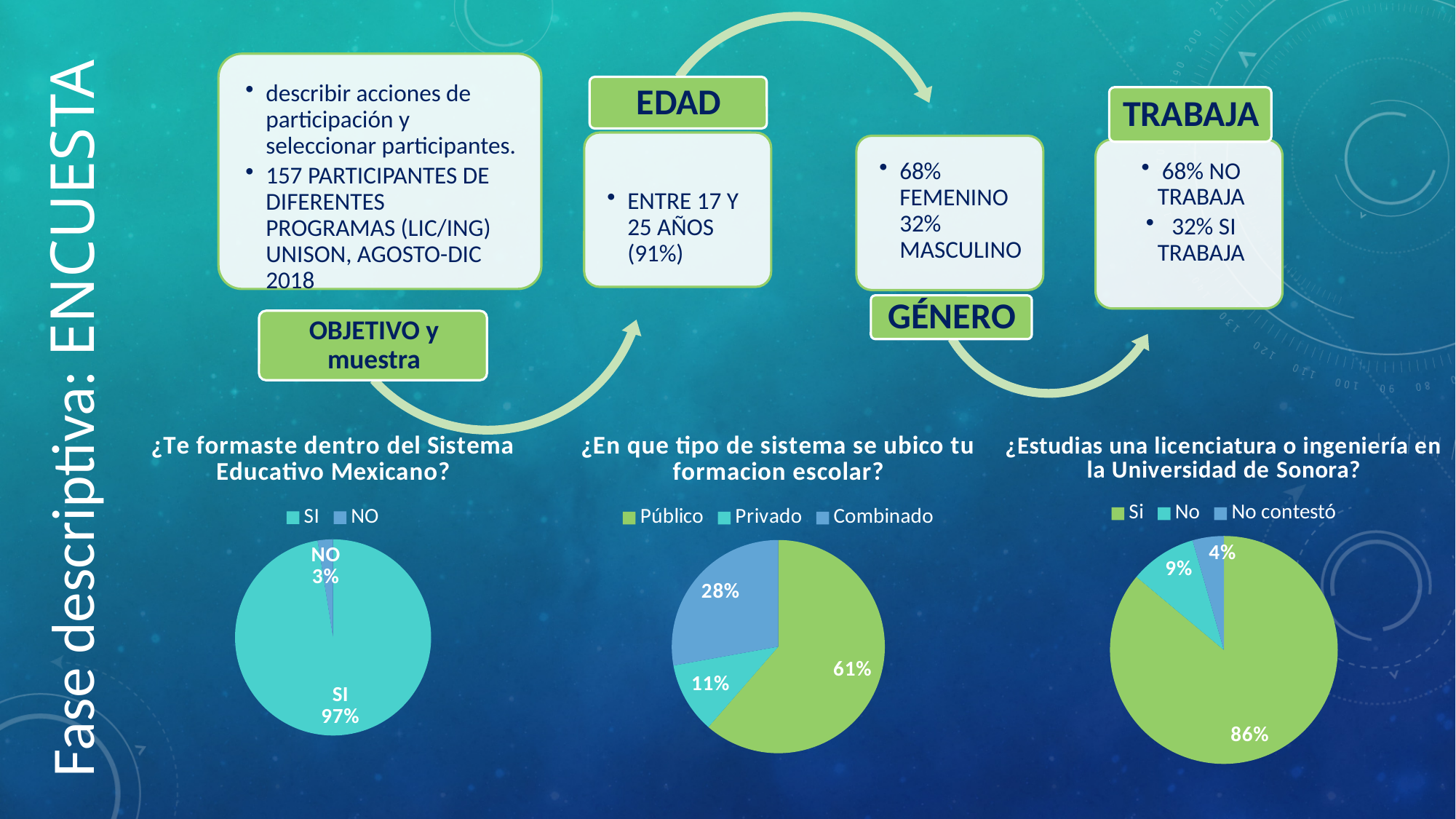
What kind of chart is used for '¿Te formaste dentro del Sistema Educativo Mexicano?'? Pie chart In the pie chart titled '¿En que tipo de sistema se ubico tu formacion escolar?', what is the share for Público? 61% In the pie chart titled '¿En que tipo de sistema se ubico tu formacion escolar?', which category has the smallest slice? Privado In the pie chart titled '¿Te formaste dentro del Sistema Educativo Mexicano?', what percentage answered NO? 3% How many pie charts are shown on the slide? 3 In the pie chart titled '¿Te formaste dentro del Sistema Educativo Mexicano?', what percentage answered SI? 97% In the pie chart titled '¿En que tipo de sistema se ubico tu formacion escolar?', what is the share for Privado? 11% In the pie chart titled '¿Estudias una licenciatura o ingeniería en la Universidad de Sonora?', what percentage answered Si? 86% In the pie chart titled '¿Estudias una licenciatura o ingeniería en la Universidad de Sonora?', which is larger, No or No contestó? No In the pie chart titled '¿Estudias una licenciatura o ingeniería en la Universidad de Sonora?', what percentage answered No contestó? 4% In the pie chart titled '¿En que tipo de sistema se ubico tu formacion escolar?', what is the difference between the Público and Combinado shares? 33% How many series does the legend list in the pie chart titled '¿En que tipo de sistema se ubico tu formacion escolar?'? 3